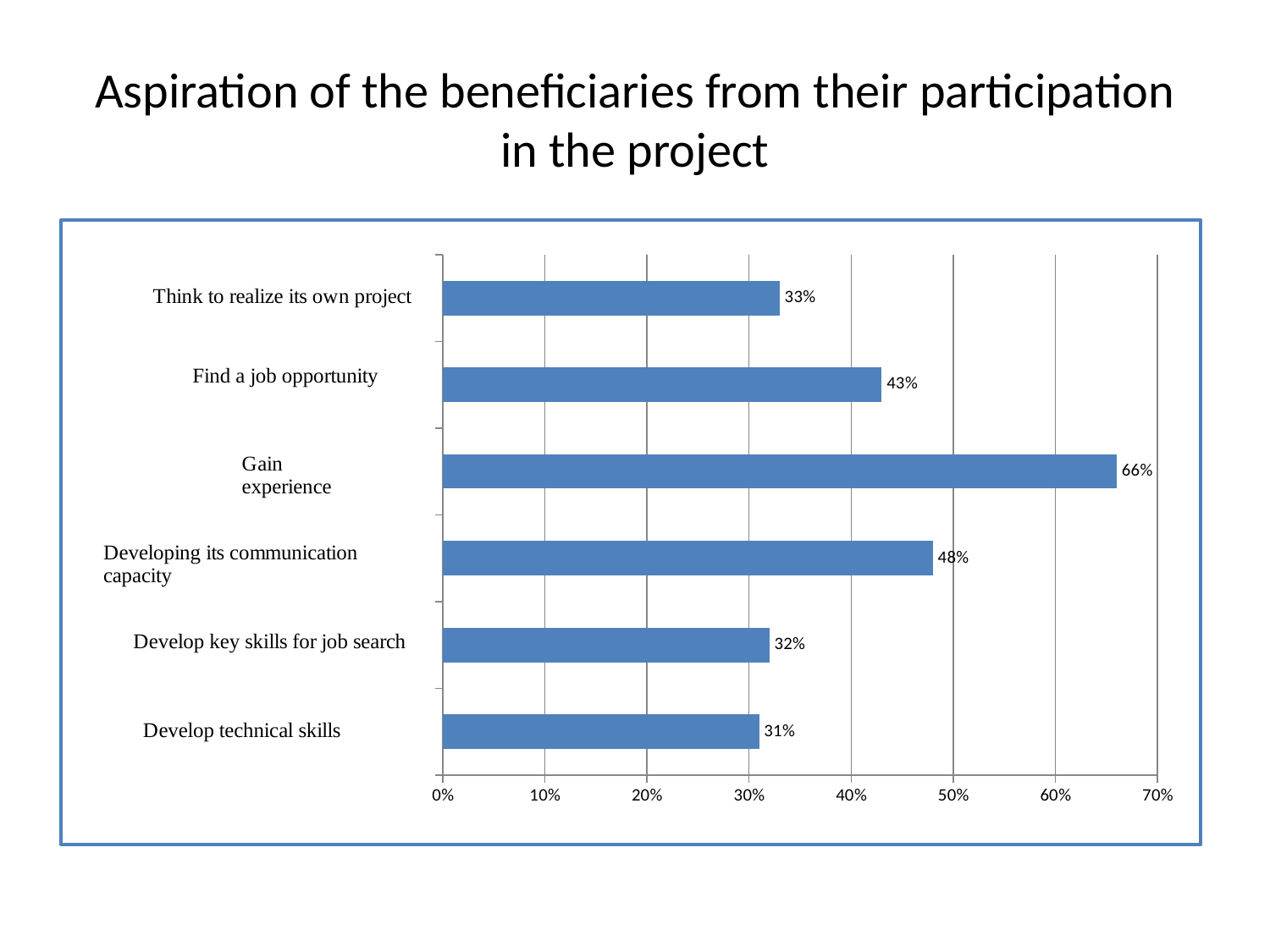
What is the value for "Gain experience"? 66% Which category has the lowest value? Develop technical skills What is the value for "Developing its communication capacity"? 48% Which category has the highest value? Gain experience What is the title of the slide? Aspiration of the beneficiaries from their participation in the project What is the value for "Find a job opportunity"? 43% What is the value for "Develop technical skills"? 31% What is the difference between the values for "Gain experience" and "Find a job opportunity"? 23% What kind of chart is shown on the slide? Bar chart How many categories are shown in the chart? 6 Which is larger, the value for "Think to realize its own project" or the value for "Find a job opportunity"? Find a job opportunity Is the value for "Developing its communication capacity" greater or less than 40%? greater